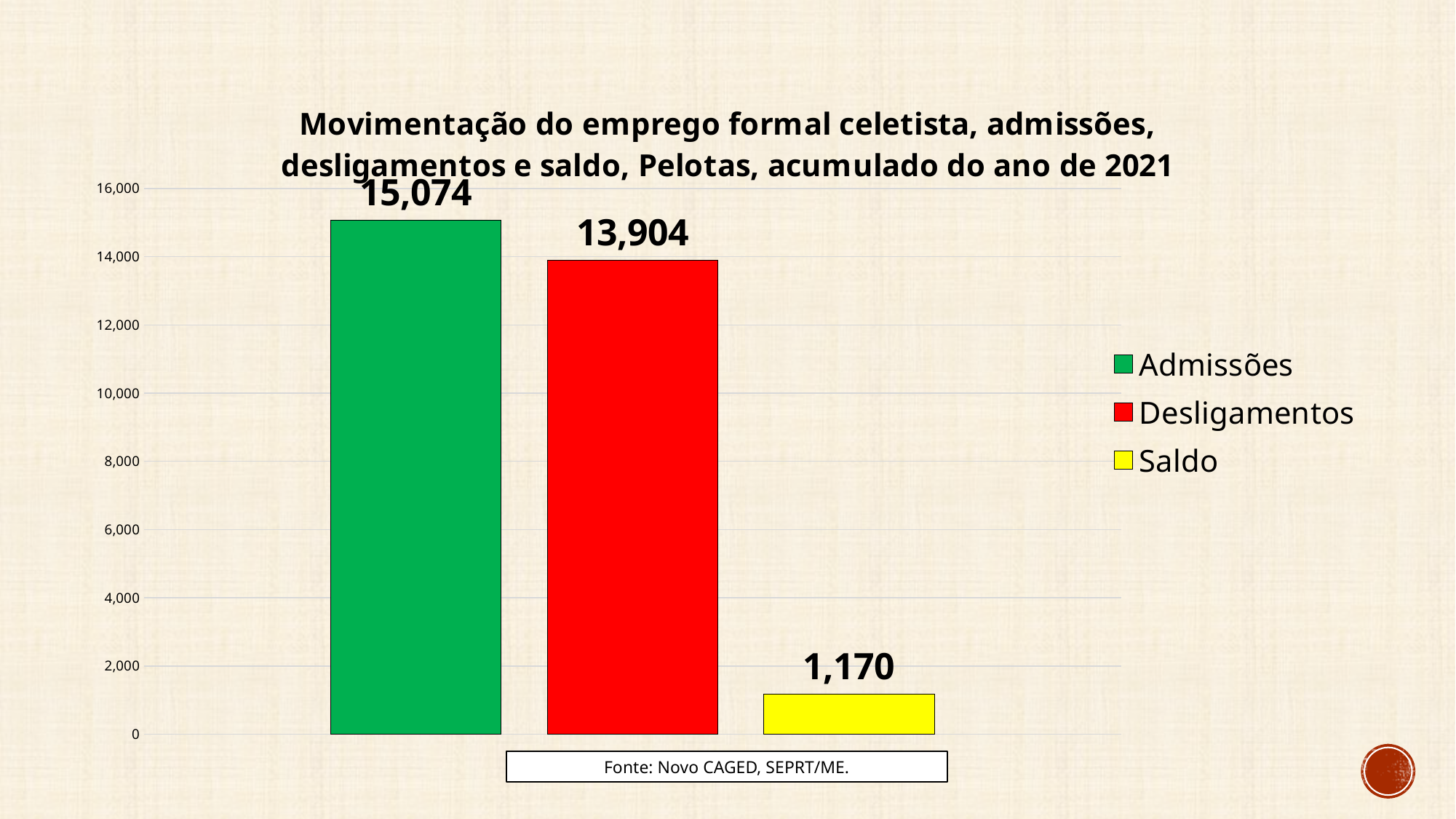
Which is larger, Desligamentos or Saldo? Desligamentos What is the value for Desligamentos? 13,904 Is the value for Desligamentos greater or less than 14,000? less What is the difference between Admissões and Desligamentos? 1,170 What kind of chart is shown on the slide? bar chart Which series has the lowest value? Saldo What colour is the bar for Saldo? yellow What is the value for Admissões? 15,074 What is the value for Saldo? 1,170 Which series has the highest value? Admissões How many series does the legend list? 3 How many bars are plotted in the chart? 3